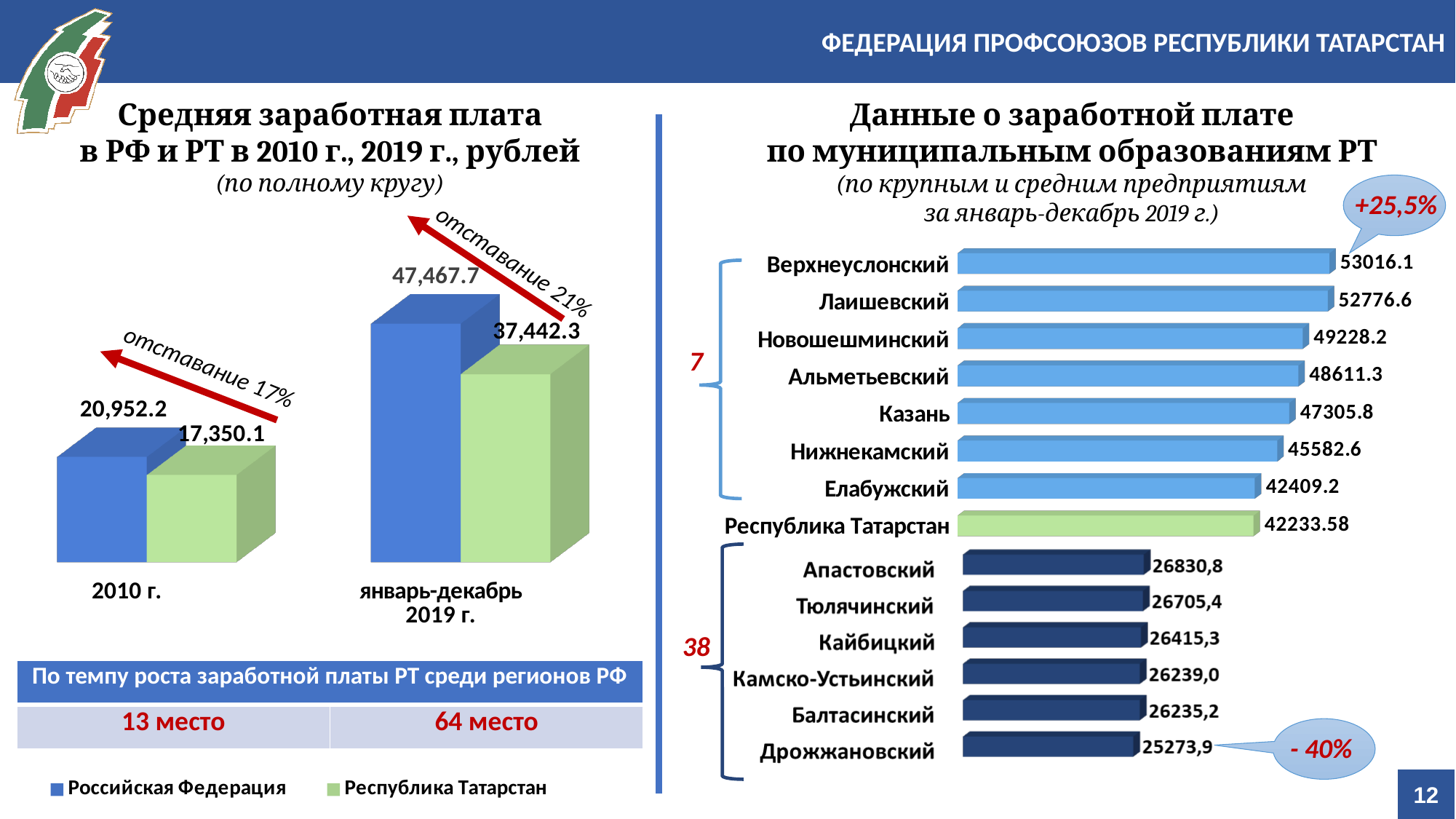
What kind of chart is the right chart (Данные о заработной плате по муниципальным образованиям РТ)? bar chart On the right chart (Данные о заработной плате по муниципальным образованиям РТ), which category has the lowest value? Дрожжановский On the right chart (Данные о заработной плате по муниципальным образованиям РТ), which category has the highest value? Верхнеуслонский On the left chart (Средняя заработная плата в РФ и РТ), what is the value for Республика Татарстан in январь-декабрь 2019 г.? 37,442.3 On the right chart (Данные о заработной плате по муниципальным образованиям РТ), how many categories are shown? 14 On the left chart (Средняя заработная плата в РФ и РТ), what is the difference between Российская Федерация and Республика Татарстан in январь-декабрь 2019 г.? 10,025.4 On the right chart (Данные о заработной плате по муниципальным образованиям РТ), what is the value for Республика Татарстан? 42233.58 On the left chart (Средняя заработная плата в РФ и РТ), what is the value for Российская Федерация in 2010 г.? 20,952.2 On the right chart (Данные о заработной плате по муниципальным образованиям РТ), what is the value for Казань? 47305.8 On the left chart (Средняя заработная плата в РФ и РТ), do the values for Республика Татарстан rise or fall from 2010 г. to январь-декабрь 2019 г.? rise On the right chart (Данные о заработной плате по муниципальным образованиям РТ), which is larger: Нижнекамский or Елабужский? Нижнекамский On the left chart (Средняя заработная плата в РФ и РТ), how many series does the legend list? 2